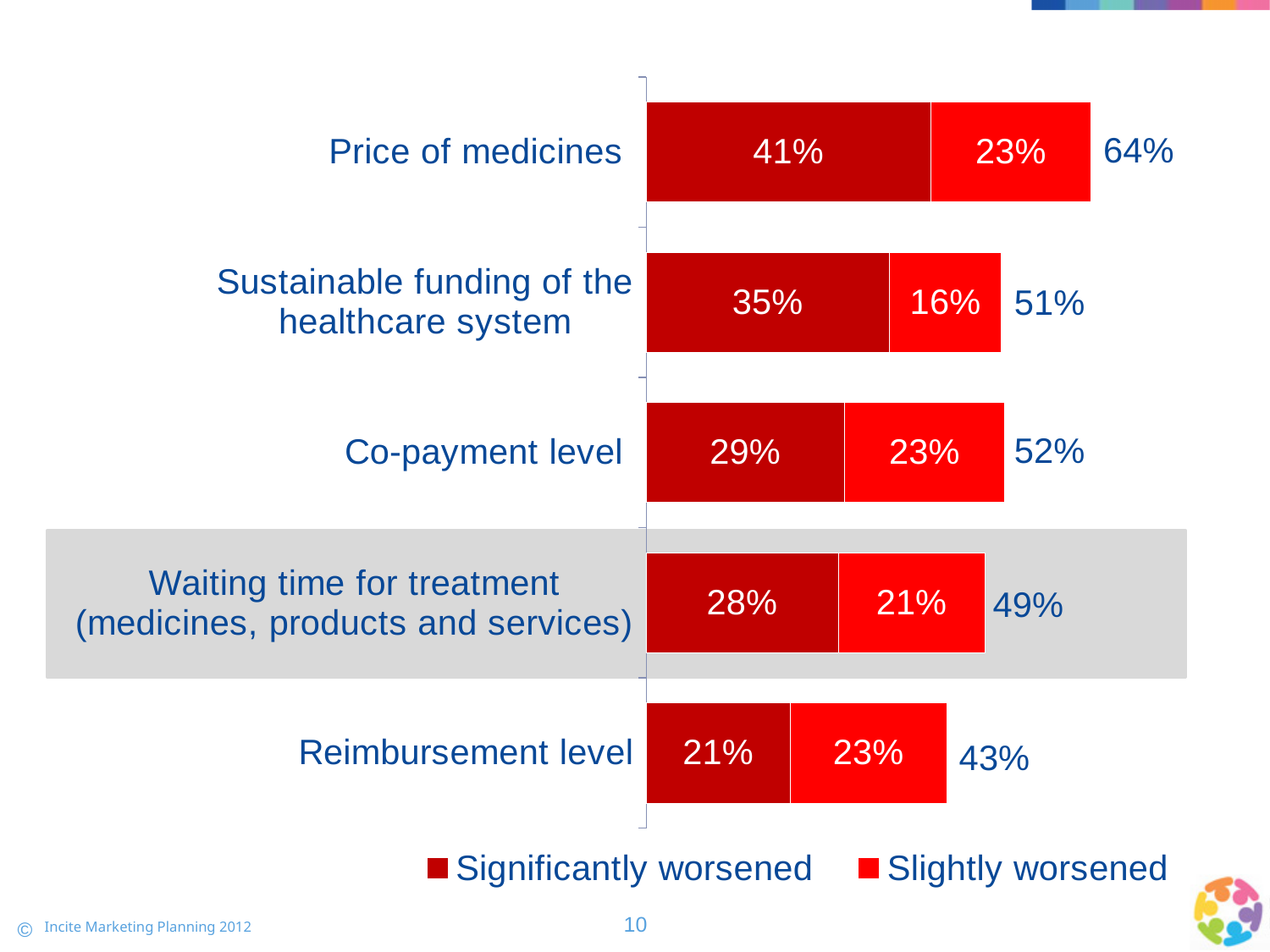
What is the difference between the 'Significantly worsened' values for Price of medicines and Co-payment level? 12% What is the 'Significantly worsened' value for Price of medicines? 41% What is the 'Significantly worsened' value for Waiting time for treatment (medicines, products and services)? 28% Which category is highlighted with a grey background band? Waiting time for treatment (medicines, products and services) Which is larger: the 'Slightly worsened' value for Co-payment level or for Sustainable funding of the healthcare system? Co-payment level Which category has the highest 'Significantly worsened' value? Price of medicines What is the 'Slightly worsened' value for Sustainable funding of the healthcare system? 16% What kind of chart is shown on the slide? Stacked bar chart Which category has the lowest 'Significantly worsened' value? Reimbursement level What is the total shown for the Co-payment level bar? 52% How many categories are plotted in the chart? 5 How many series does the legend list? 2